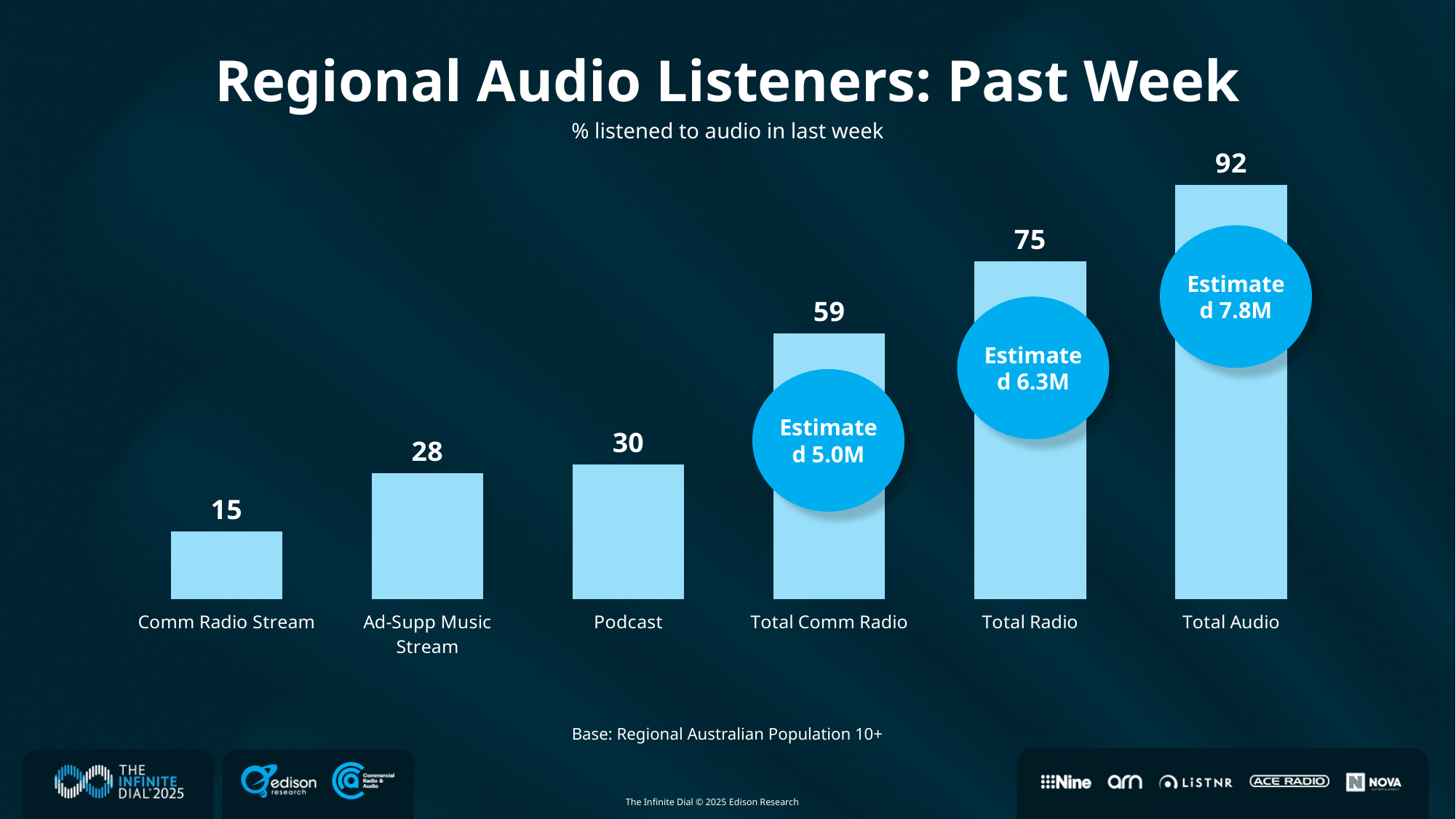
How many categories are shown in the chart? 6 What is the value for Total Radio? 75 What is the value for Comm Radio Stream? 15 What is the difference between Total Audio and Total Comm Radio? 33 Which category has the lowest value? Comm Radio Stream Which is larger, Total Radio or Total Comm Radio? Total Radio What kind of chart is shown on the slide? Bar chart What estimated number of listeners is shown in the circle on the Total Audio bar? Estimated 7.8M What is the difference between Ad-Supp Music Stream and Comm Radio Stream? 13 Do the values rise or fall from left to right across the categories? Rise What is the value for Podcast? 30 Which category has the highest value? Total Audio